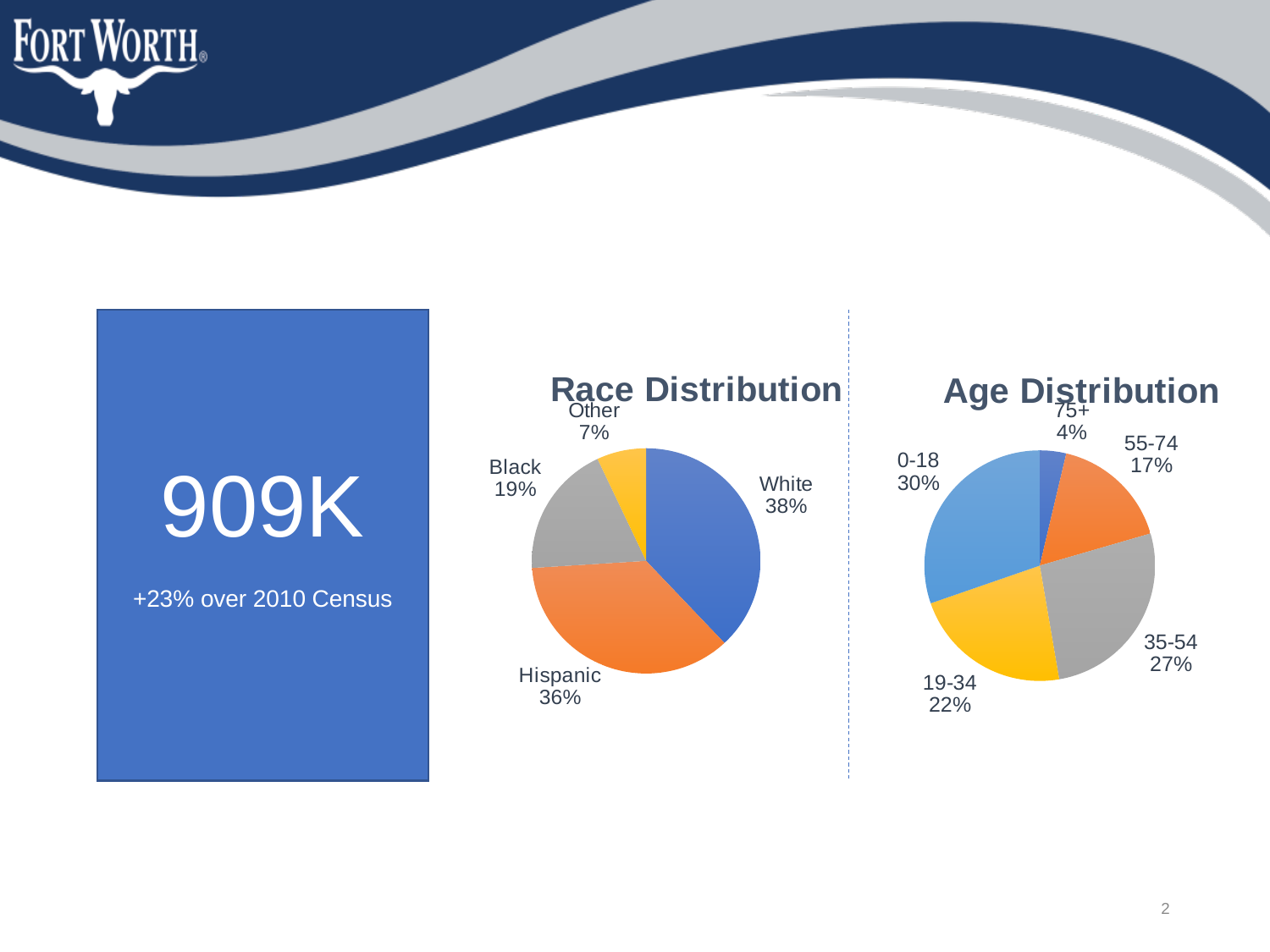
In the Age Distribution chart, which is larger, the 35-54 share or the 19-34 share? 35-54 In the Race Distribution chart, what share is White? 38% In the Age Distribution chart, which age group has the largest share? 0-18 In the Race Distribution chart, what share is Hispanic? 36% In the Age Distribution chart, which age group has the smallest share? 75+ In the Age Distribution chart, how many age groups are shown? 5 In the Age Distribution chart, what share is the 55-74 group? 17% In the Race Distribution chart, which category has the smallest share? Other In the Race Distribution chart, what is the difference between the Hispanic and Black shares? 17% What kind of chart is the Race Distribution chart? Pie chart In the Age Distribution chart, what share is the 0-18 group? 30% In the Race Distribution chart, how many categories are shown? 4